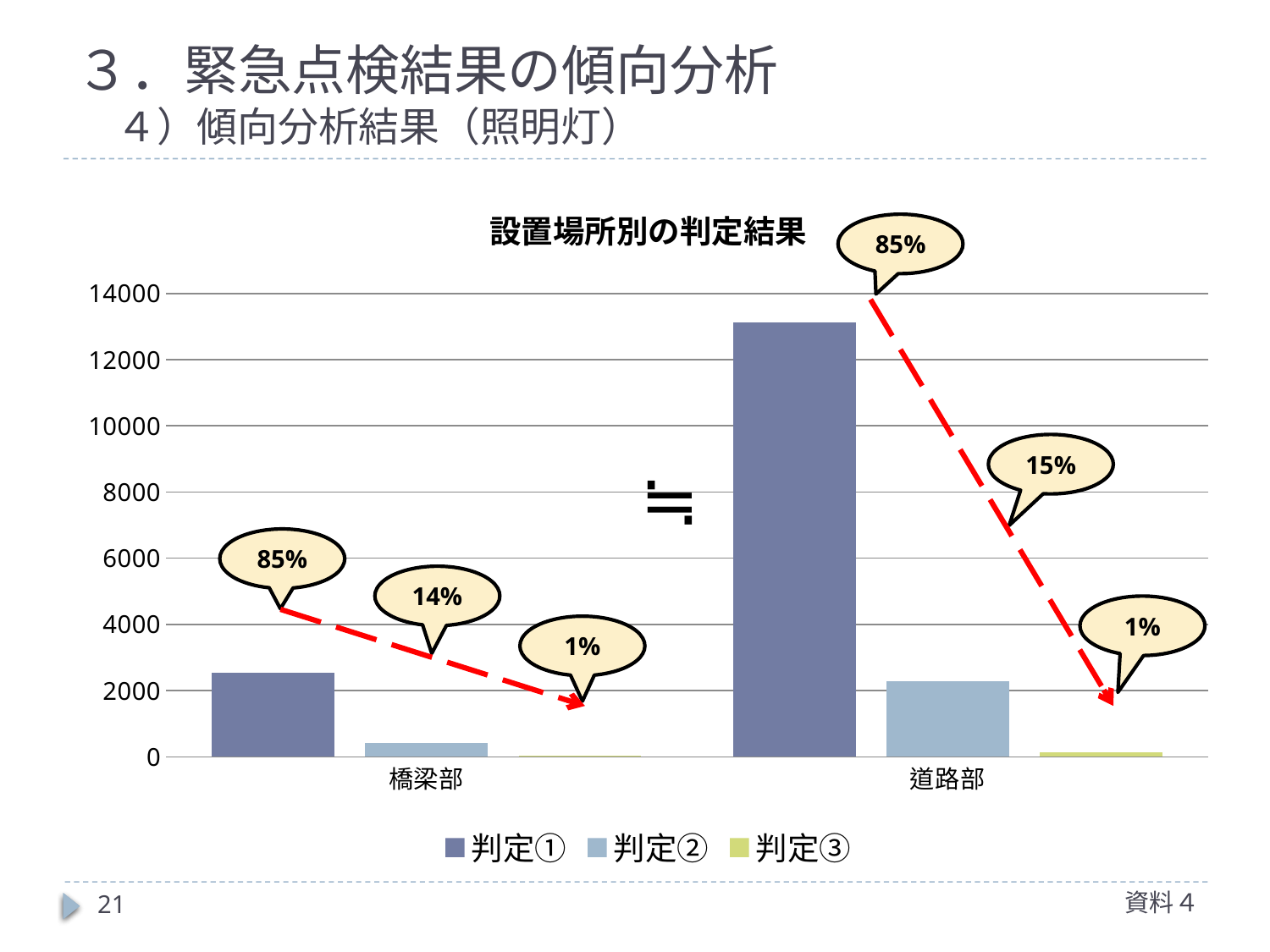
Is the 判定① value for 道路部 greater or less than 12000? greater Is the 判定② value for 橋梁部 greater or less than 2000? less What is the title of the chart? 設置場所別の判定結果 Which is larger, the 判定② value for 橋梁部 or for 道路部? 道路部 Which series has the lowest bar in 道路部? 判定③ How many series does the legend list? 3 How many categories are shown on the x axis? 2 What kind of chart is shown on the slide? bar chart Is the 判定① value for 橋梁部 greater or less than 4000? less Which category has the highest 判定① bar? 道路部 What percentage is shown in the callout pointing to the 判定② bar for 道路部? 15%